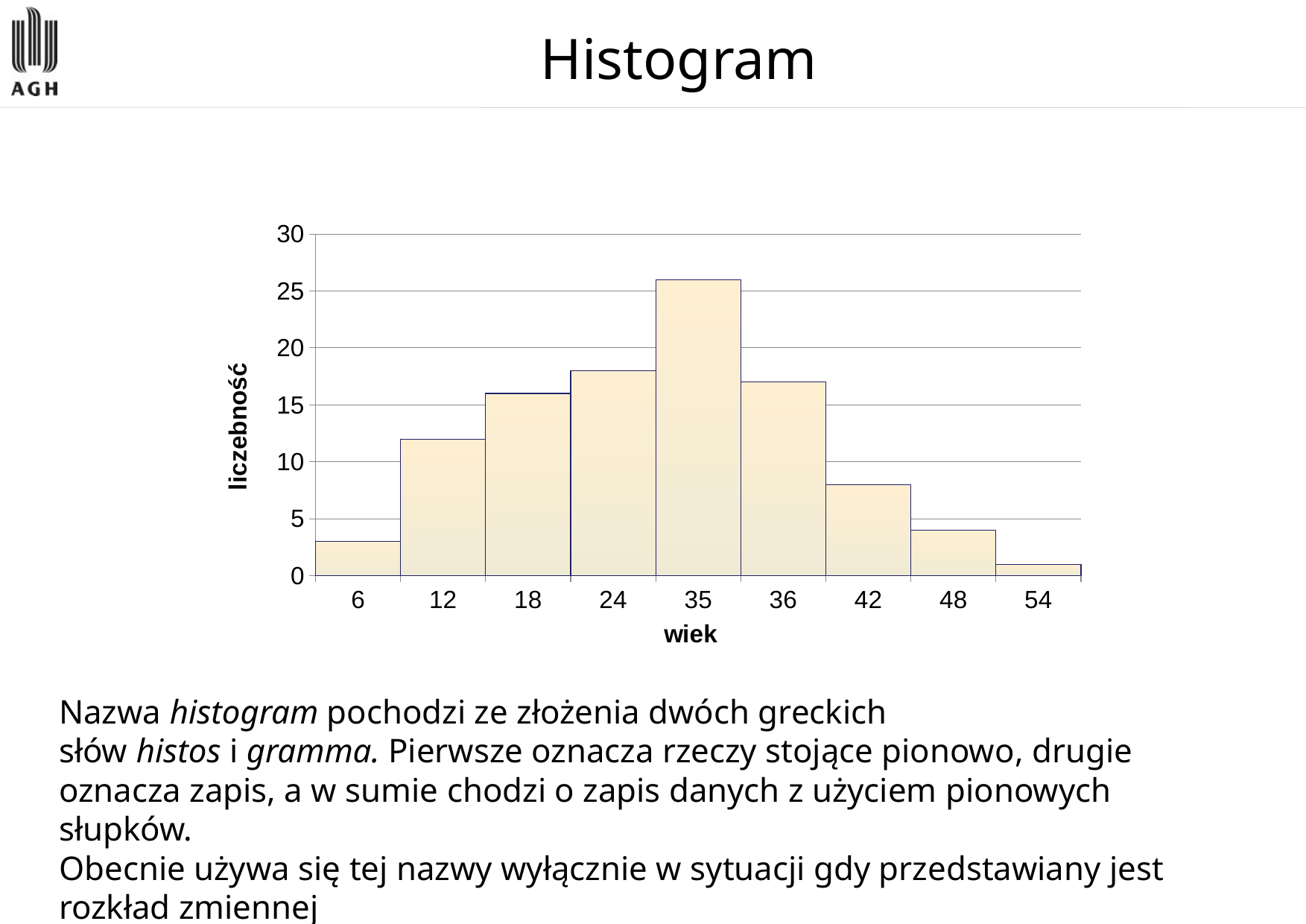
How many bars are plotted in the chart? 9 Is the value for wiek 12 greater or less than 10? greater Is the value for wiek 54 greater or less than 5? less Which has a larger liczebność, wiek 42 or wiek 48? 42 Which has a larger liczebność, wiek 12 or wiek 18? 18 What is the label of the vertical axis of the chart? liczebność Is the value for wiek 6 greater or less than 5? less Which age category (wiek) has the highest liczebność? 35 What kind of chart is shown on the slide? bar chart Which age category (wiek) has the lowest liczebność? 54